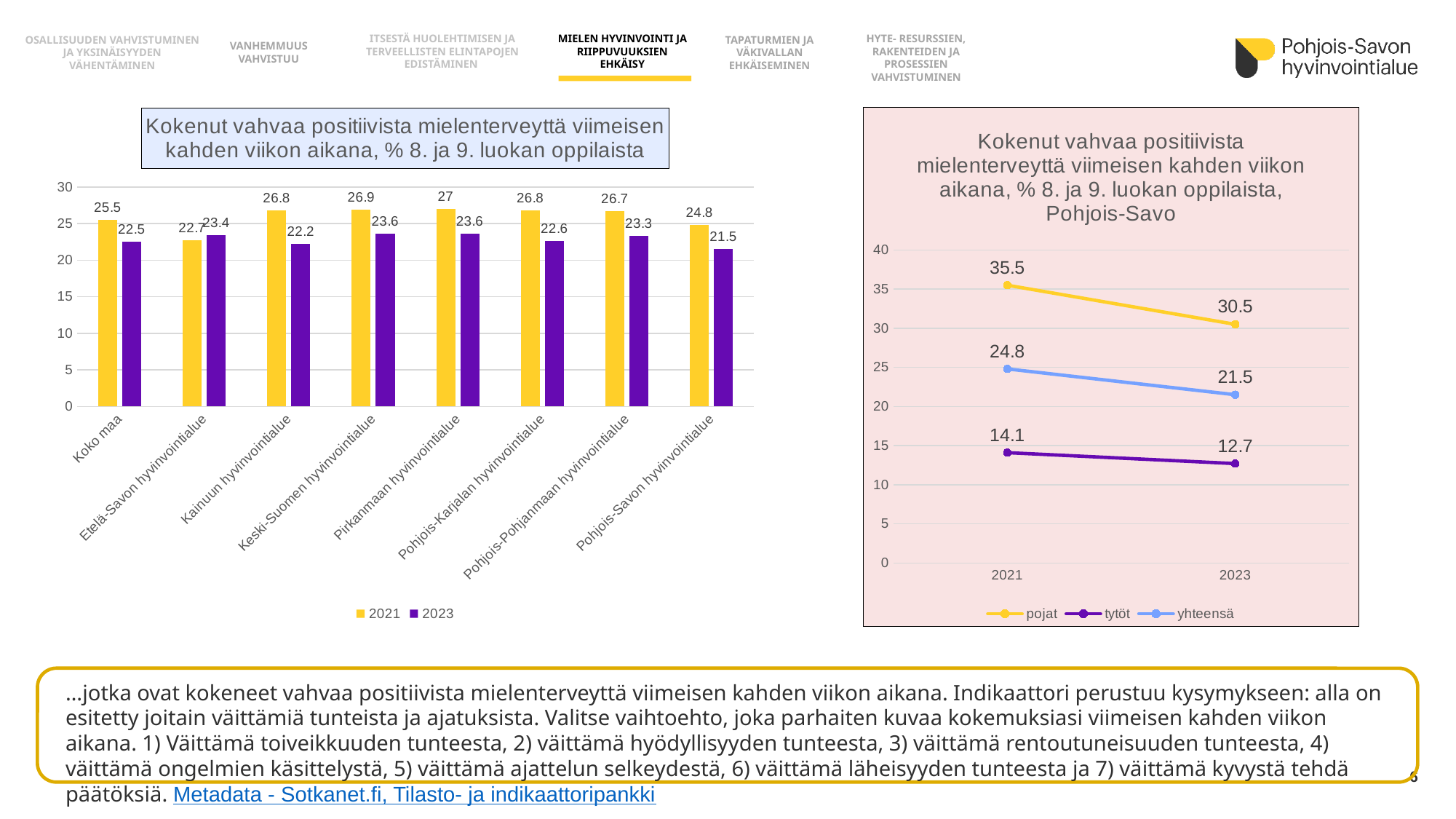
In the left bar chart, which category has the lowest 2021 value? Etelä-Savon hyvinvointialue In the left bar chart, which category has the lowest 2023 value? Pohjois-Savon hyvinvointialue In the left bar chart, what is the 2021 value for Pohjois-Savon hyvinvointialue? 24.8 In the left bar chart, what is the 2023 value for Koko maa? 22.5 In the right line chart, what is the difference between the pojat and tytöt values in 2023? 17.8 How many categories are shown on the x axis of the left bar chart? 8 How many series does the legend of the left bar chart list? 2 In the right line chart, what is the value for pojat in 2021? 35.5 What kind of chart is the chart on the right side of the slide? Line chart In the right line chart, how does the value for tytöt change from 2021 to 2023? It falls In the left bar chart, is the 2021 value or the 2023 value larger for Etelä-Savon hyvinvointialue? 2023 In the left bar chart, what is the difference between the 2021 and 2023 values for Kainuun hyvinvointialue? 4.6